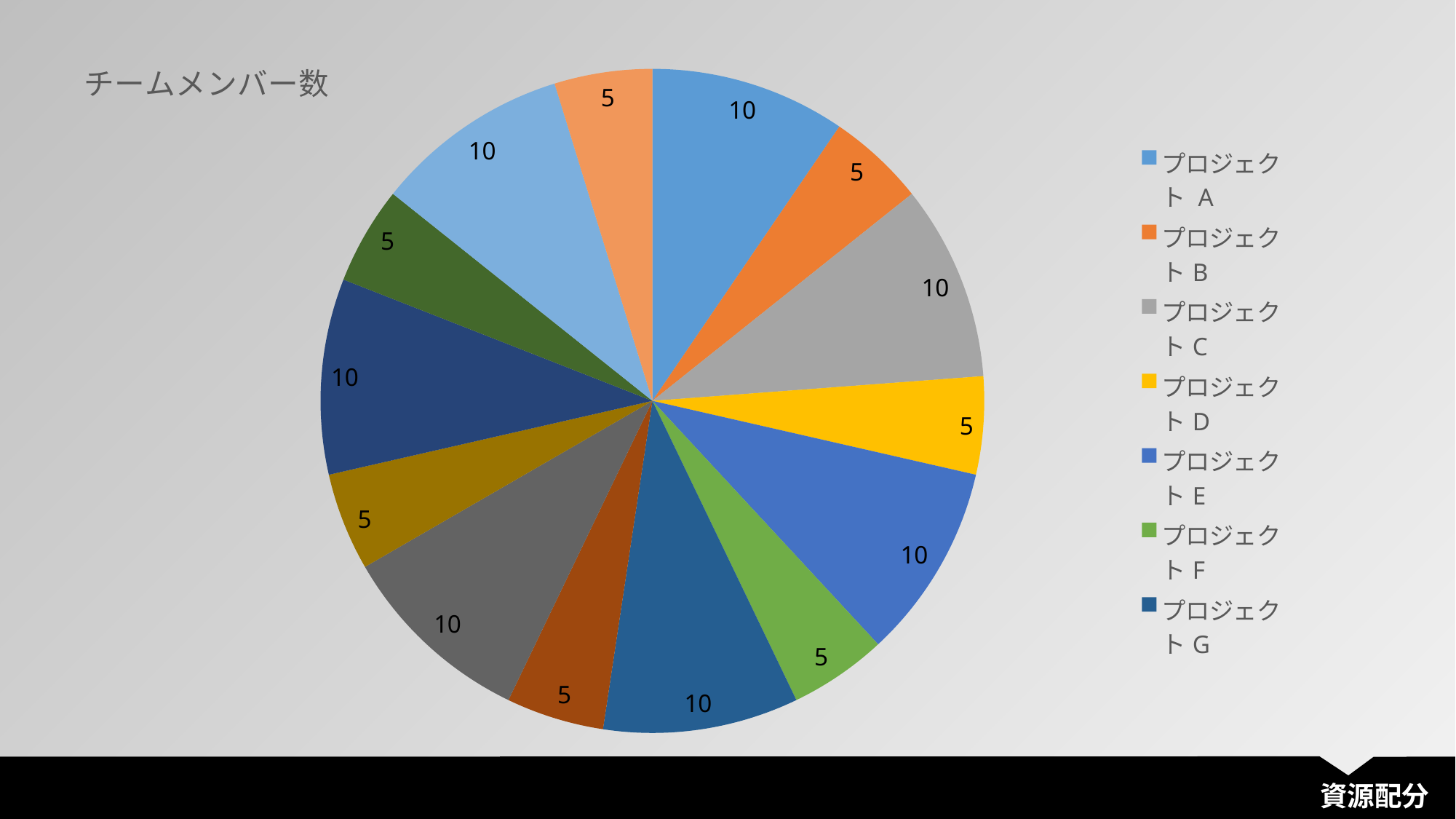
What is the value for プロジェクト A? 10 Which is larger, the value for プロジェクト A or プロジェクト B? プロジェクト A What is the title of the chart? チームメンバー数 What is the value for プロジェクト E? 10 What is the value for プロジェクト C? 10 What is the value for プロジェクト D? 5 What is the value for プロジェクト B? 5 What is the value for プロジェクト F? 5 How many entries does the legend list? 7 What type of chart is shown on the slide? pie chart What is the value for プロジェクト G? 10 What is the difference between the values for プロジェクト C and プロジェクト D? 5